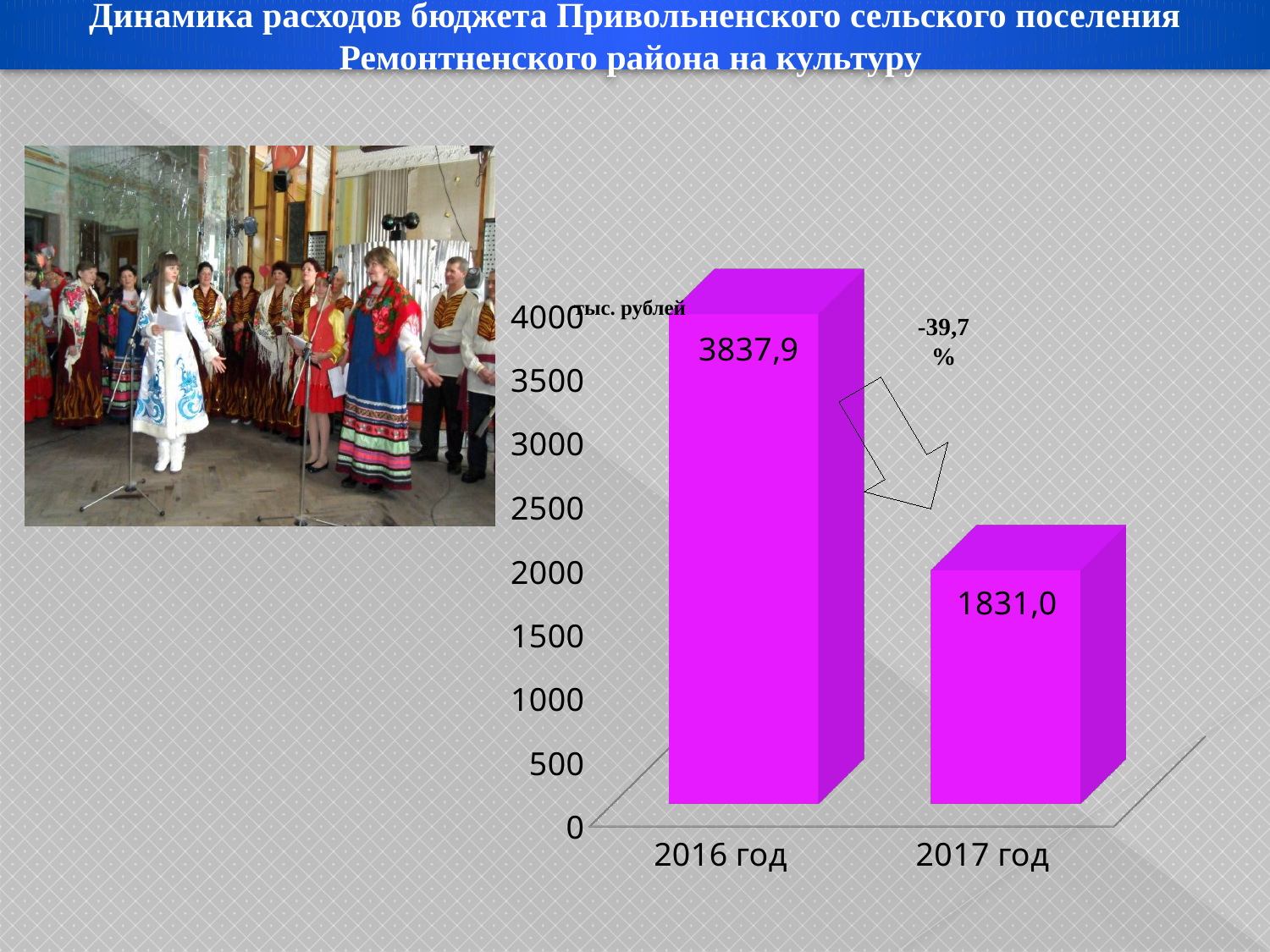
Which year has the highest value? 2016 год What is the difference between the values for 2016 год and 2017 год? 2006,9 What kind of chart is shown on the slide? bar chart Is the value for 2016 год greater or less than 3500? greater Is the value for 2017 год greater or less than 2000? less Which is larger, the value for 2016 год or for 2017 год? 2016 год How many categories are shown on the x axis? 2 Do the values rise or fall from 2016 год to 2017 год? fall Which year has the lowest value? 2017 год What percentage change is annotated next to the arrow between the bars? -39,7 % What is the value for 2017 год? 1831,0 What is the value for 2016 год? 3837,9